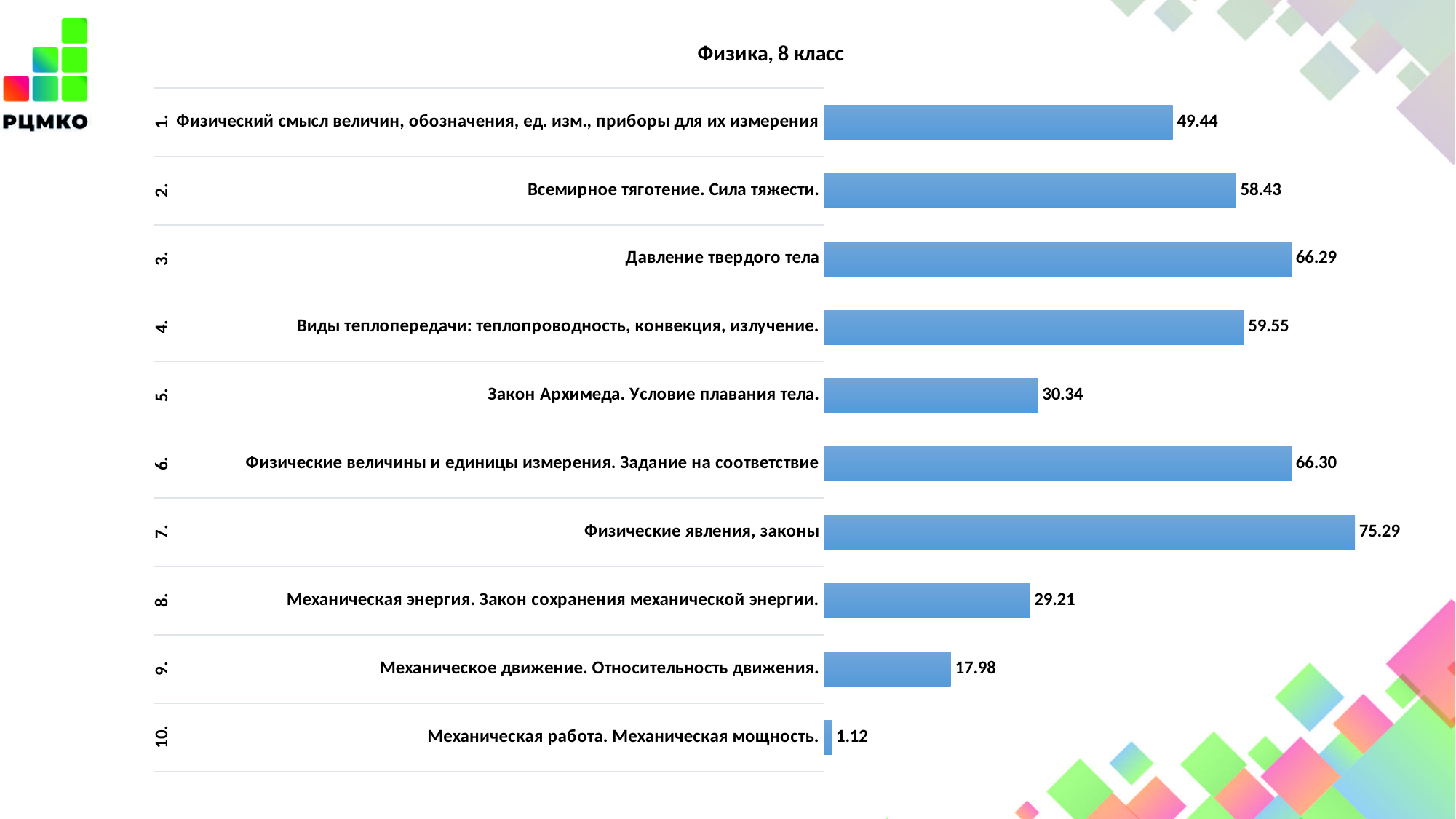
What is the value for "Давление твердого тела"? 66.29 How many categories are shown in the chart? 10 What is the title of the chart? Физика, 8 класс Which is larger: the value for "Виды теплопередачи: теплопроводность, конвекция, излучение." or the value for "Всемирное тяготение. Сила тяжести."? Виды теплопередачи: теплопроводность, конвекция, излучение. What is the difference between the values for "Давление твердого тела" and "Закон Архимеда. Условие плавания тела."? 35.95 What is the value for "Всемирное тяготение. Сила тяжести."? 58.43 What is the value for "Закон Архимеда. Условие плавания тела."? 30.34 What is the value for "Механическая работа. Механическая мощность."? 1.12 What is the difference between the values for "Физические явления, законы" and "Механическое движение. Относительность движения."? 57.31 What kind of chart is shown on the slide? Bar chart Which category has the highest value? Физические явления, законы Which category has the lowest value? Механическая работа. Механическая мощность.